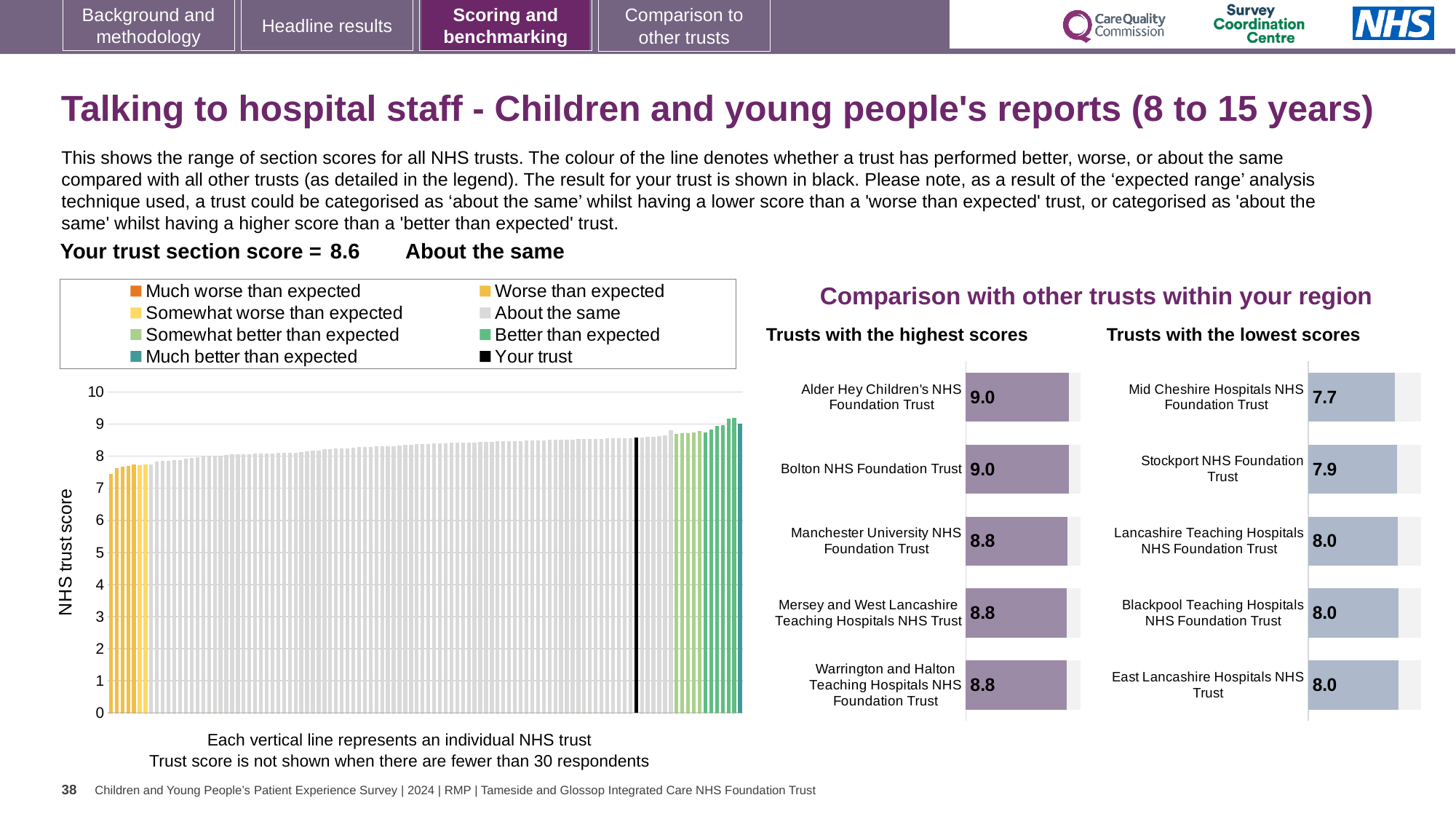
In the 'Trusts with the highest scores' chart, which has the larger score: Bolton NHS Foundation Trust or Manchester University NHS Foundation Trust? Bolton NHS Foundation Trust In the 'Trusts with the lowest scores' chart, what is the difference between the scores for Stockport NHS Foundation Trust and Mid Cheshire Hospitals NHS Foundation Trust? 0.2 What is the difference between the score for Alder Hey Children's NHS Foundation Trust in the highest scores chart and the score for Mid Cheshire Hospitals NHS Foundation Trust in the lowest scores chart? 1.3 How many entries does the legend of the main chart on the left list? 8 In the 'Trusts with the highest scores' chart, what is the score for Manchester University NHS Foundation Trust? 8.8 How many trusts are shown in the 'Trusts with the lowest scores' chart? 5 In the 'Trusts with the lowest scores' chart, what is the score for Mid Cheshire Hospitals NHS Foundation Trust? 7.7 In the 'Trusts with the lowest scores' chart, what is the score for Stockport NHS Foundation Trust? 7.9 In the 'Trusts with the highest scores' chart, what is the score for Alder Hey Children's NHS Foundation Trust? 9.0 In the main chart on the left, is the value for the black 'Your trust' bar greater or less than 8? greater In the 'Trusts with the lowest scores' chart, which trust has the lowest score? Mid Cheshire Hospitals NHS Foundation Trust What kind of chart is the main chart on the left showing NHS trust scores? Bar chart